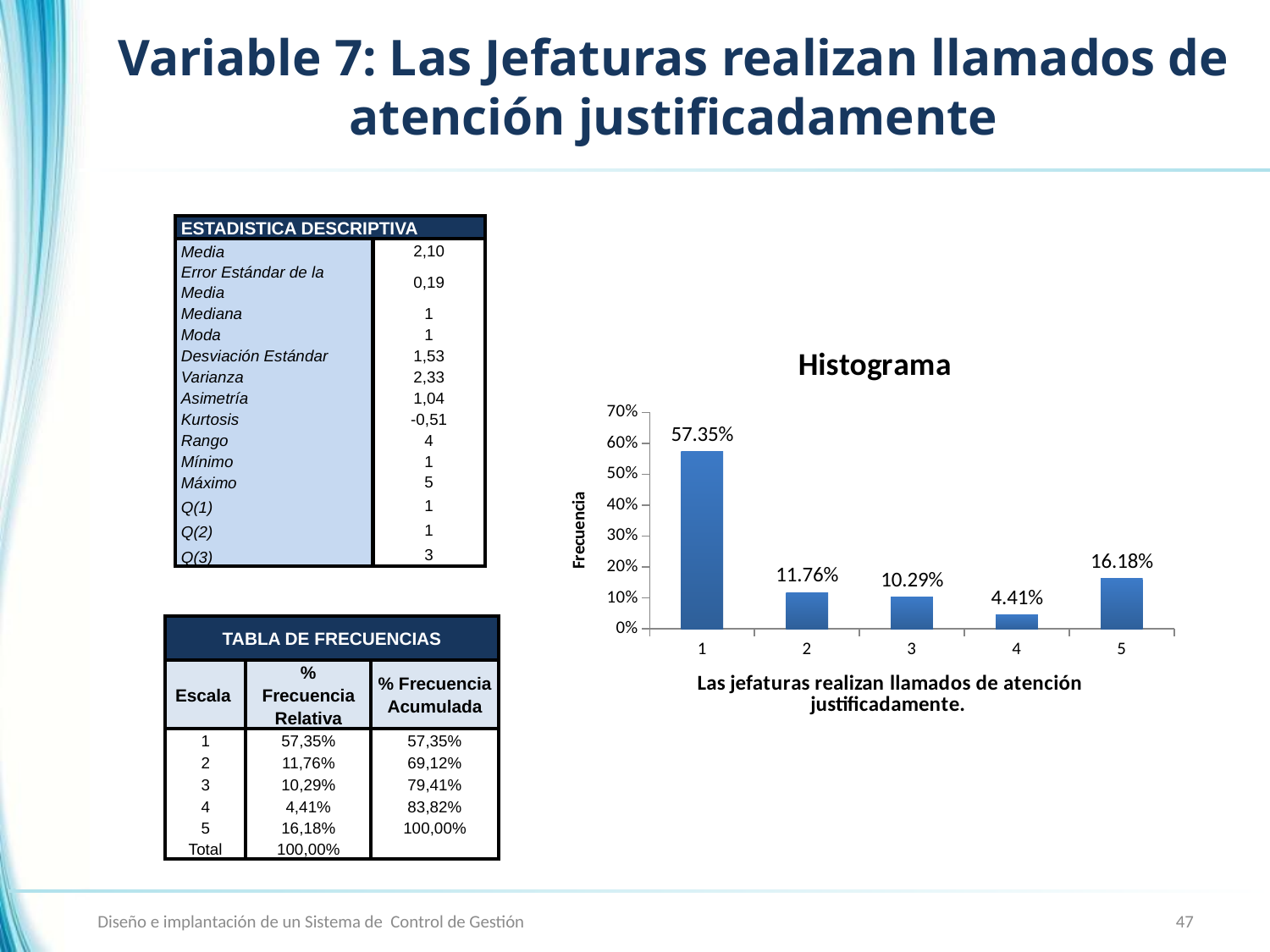
Which is larger, the value for category 3 or the value for category 5? 5 What is the value for category 2 in the histogram? 11.76% How many categories are shown on the x axis of the histogram? 5 What is the value for category 5 in the histogram? 16.18% Which category has the lowest value in the histogram? 4 What is the label of the vertical axis of the histogram? Frecuencia What is the difference between the values for category 1 and category 5? 41.17% What type of chart is shown on the slide? bar chart What is the value for category 1 in the histogram? 57.35% Which category has the highest value in the histogram? 1 What is the title of the chart? Histograma What is the value for category 4 in the histogram? 4.41%